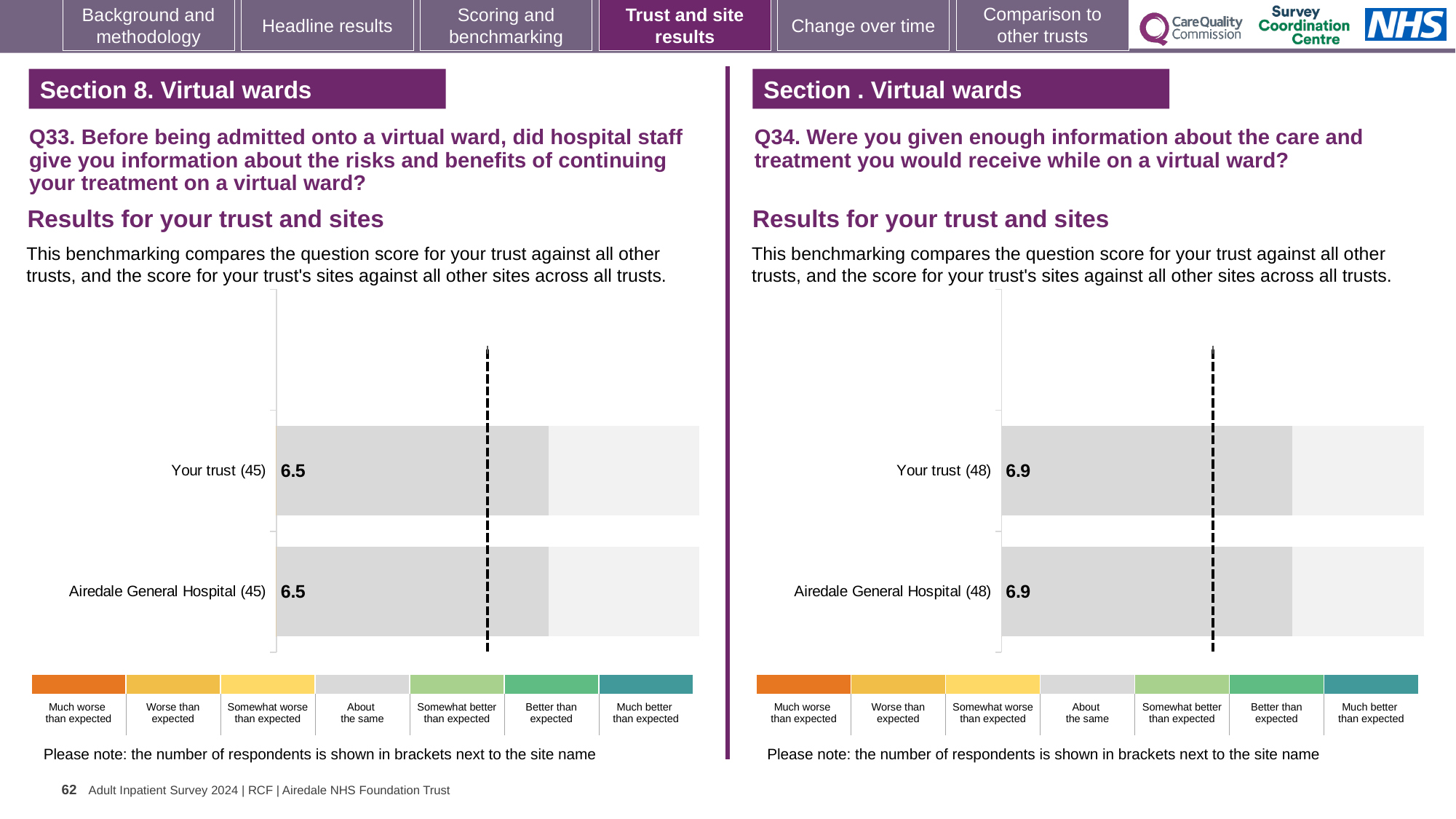
On the right chart (Q34), what is the score for Your trust? 6.9 On the right chart (Q34), what is the score for Airedale General Hospital? 6.9 On the left chart (Q33), what does the colour scale label at the far right end say? Much better than expected On the left chart (Q33), what is the score for Your trust? 6.5 What is the difference between the Your trust score on the right chart (Q34) and the Your trust score on the left chart (Q33)? 0.4 On the left chart (Q33), how many respondents are shown in brackets for Your trust? 45 What kind of chart is used on the left (Q33)? Bar chart Which chart shows the higher score for Your trust, the left chart (Q33) or the right chart (Q34)? The right chart (Q34) On the left chart (Q33), what is the score for Airedale General Hospital? 6.5 On the right chart (Q34), how many respondents are shown in brackets for Airedale General Hospital? 48 How many categories (rows) are plotted on the right chart (Q34)? 2 How many categories (rows) are plotted on the left chart (Q33)? 2